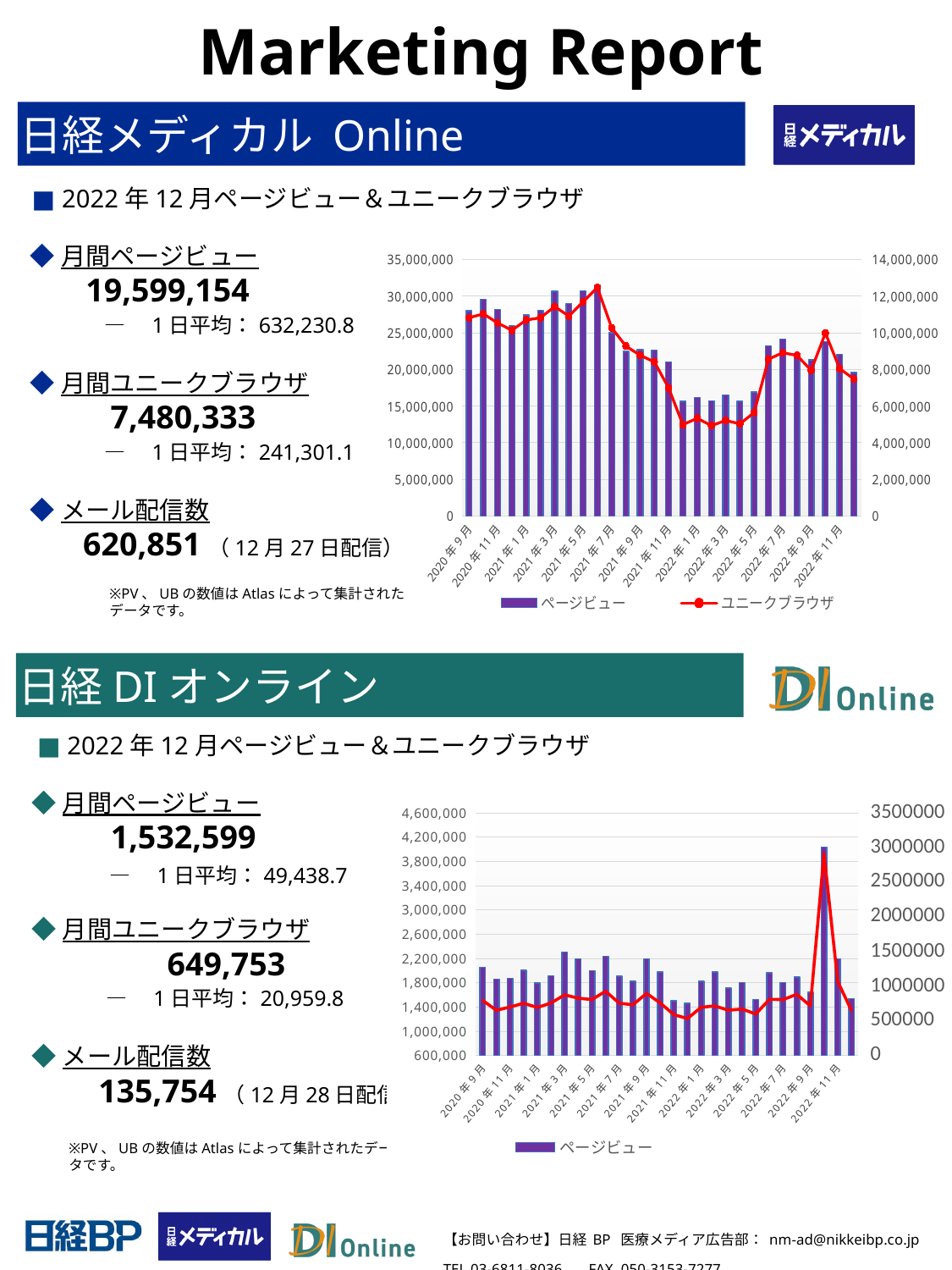
In the 日経 DI オンライン chart (bottom), how many series does the legend list? 1 In the 日経メディカル Online chart (top), do page views rise or fall between 2021年7月 and 2022年1月? fall In the 日経メディカル Online chart (top), is the unique browser value for 2021年5月 greater or less than 10,000,000 on the right axis? greater In the 日経メディカル Online chart (top), what kind of chart is used to show the data? A combined bar and line chart In the 日経メディカル Online chart (top), is the unique browser value for 2022年1月 greater or less than 6,000,000 on the right axis? less In the 日経 DI オンライン chart (bottom), is the page view value for 2020年9月 greater or less than 1,800,000? greater In the 日経 DI オンライン chart (bottom), what is the legend entry shown below the chart? ページビュー In the 日経メディカル Online chart (top), which series is drawn as a red line? ユニークブラウザ In the 日経メディカル Online chart (top), which has the higher page view value: 2020年9月 or 2022年1月? 2020年9月 In the 日経メディカル Online chart (top), how many series does the legend list? 2